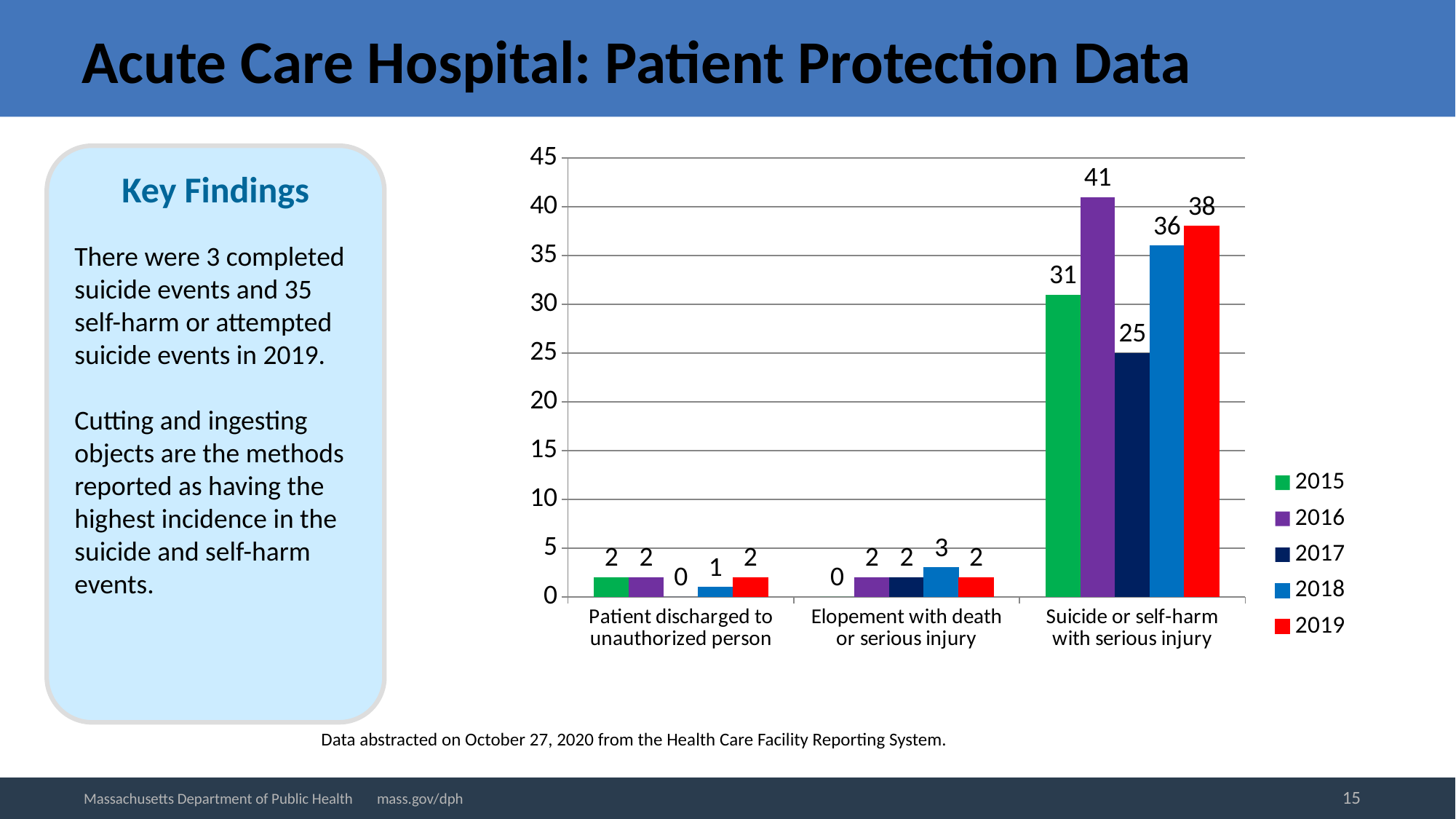
How many series does the legend list? 5 How many categories are shown on the x axis? 3 Which year has the highest value in the 'Suicide or self-harm with serious injury' category? 2016 What is the difference between the 2019 and 2015 values in the 'Suicide or self-harm with serious injury' category? 7 Which colour represents 2019 in the legend? Red What is the value for 2018 in the 'Elopement with death or serious injury' category? 3 Which year has the lowest value in the 'Suicide or self-harm with serious injury' category? 2017 What is the value for 2016 in the 'Suicide or self-harm with serious injury' category? 41 In the 'Suicide or self-harm with serious injury' category, which is larger: the 2018 value or the 2019 value? 2019 What kind of chart is shown on the slide? Bar chart What is the value for 2017 in the 'Suicide or self-harm with serious injury' category? 25 What is the value for 2017 in the 'Patient discharged to unauthorized person' category? 0